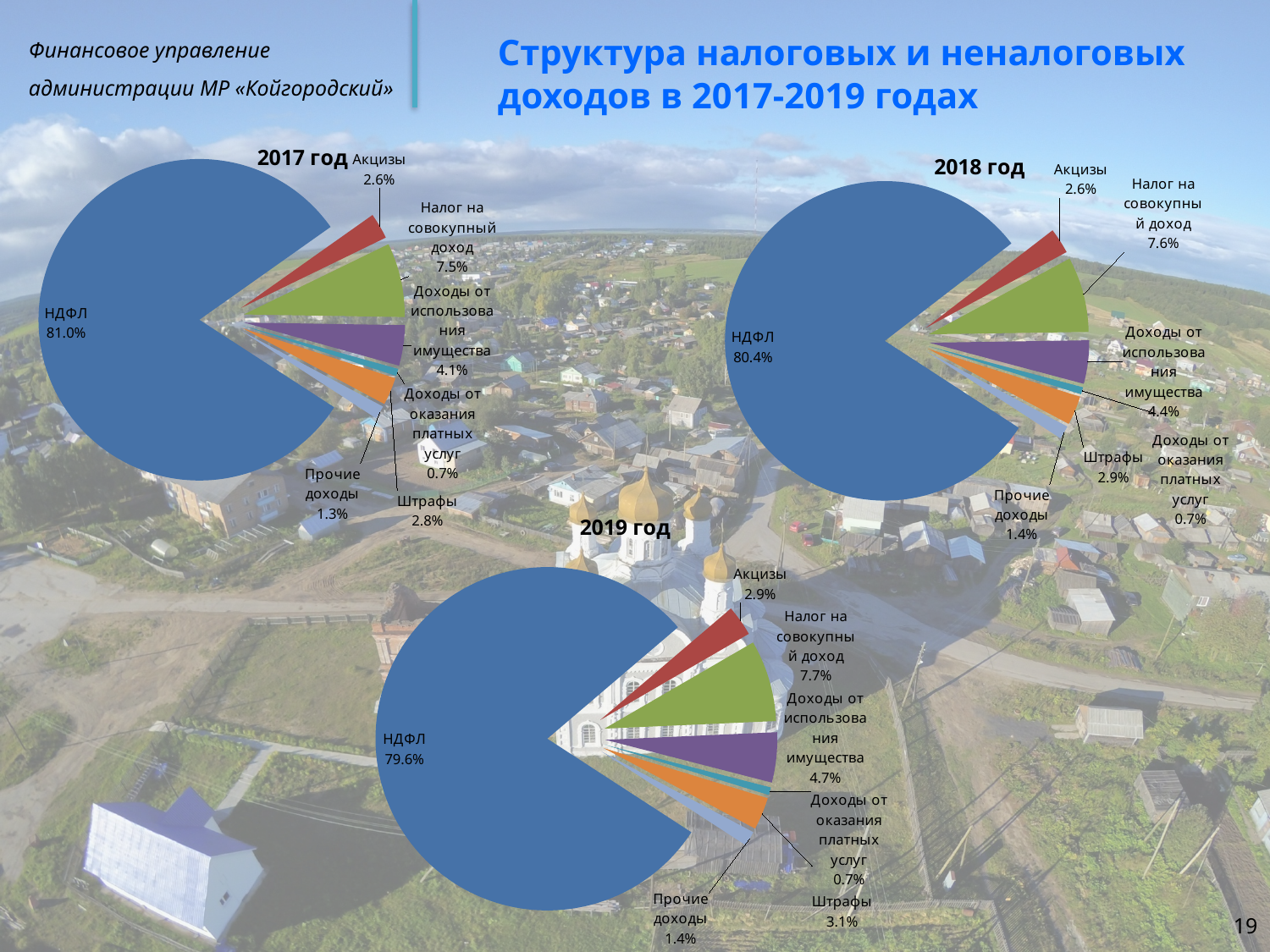
In the 2018 год chart, which category has the smallest share? Доходы от оказания платных услуг How many slices does the 2017 год pie chart have? 7 In the 2019 год chart, which category has the largest share? НДФЛ In the 2017 год chart, which is larger: Штрафы or Акцизы? Штрафы In the 2019 год chart, what is the difference between Налог на совокупный доход and Доходы от использования имущества? 3.0% Across the three charts, does the share of НДФЛ rise or fall from 2017 to 2019? fall In the 2018 год chart, what is the value for Налог на совокупный доход? 7.6% In the 2017 год chart, what share does НДФЛ have? 81.0% In the 2019 год chart, what is the value for Штрафы? 3.1% How many pie charts are shown on the slide? 3 What type of chart is used for the 2017 год chart? pie chart In the 2018 год chart, what is the value for Прочие доходы? 1.4%